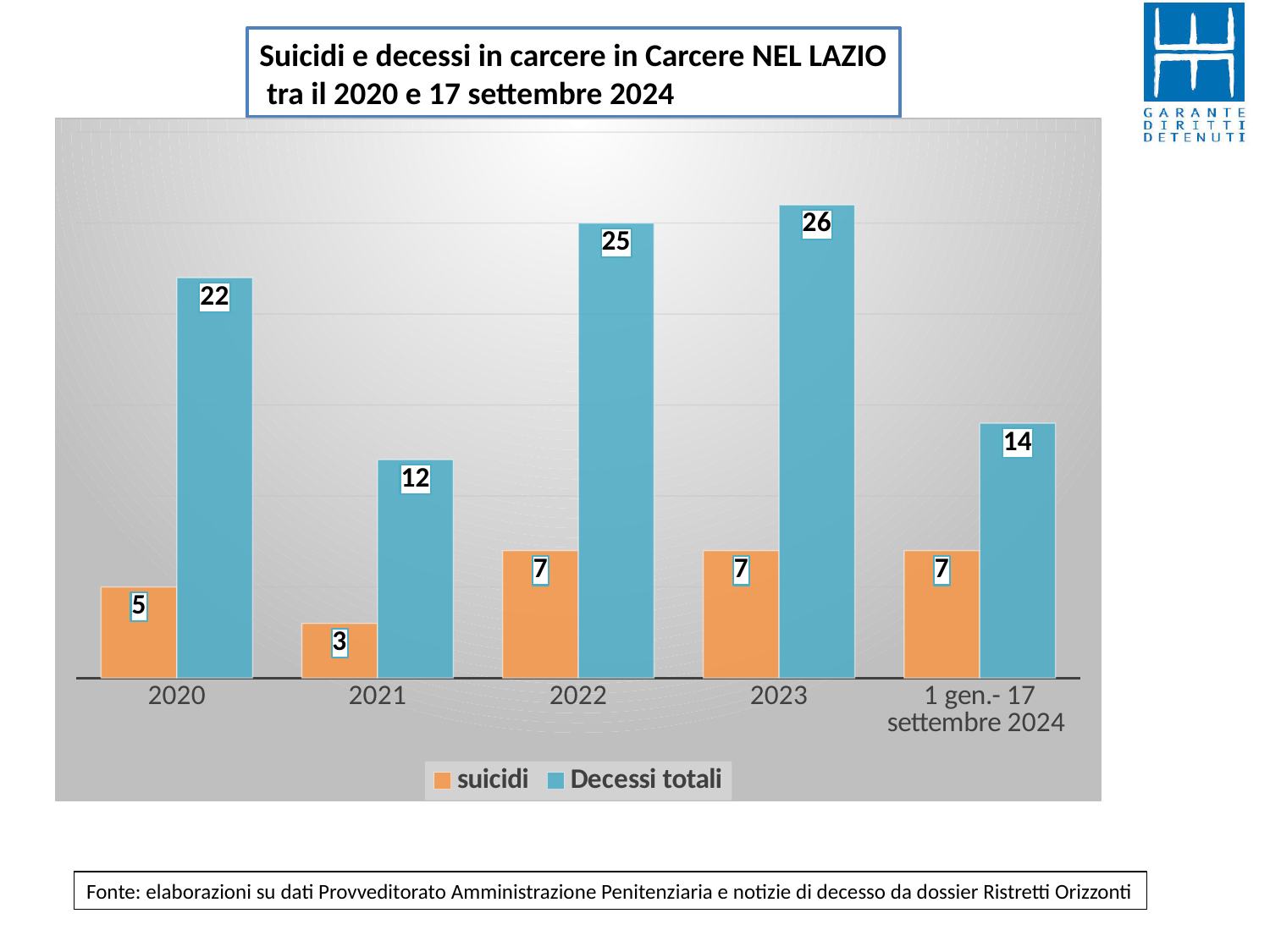
What is the value of 'suicidi' for 2021? 3 Which category has the lowest value for 'suicidi'? 2021 What is the value of 'Decessi totali' for 2020? 22 What kind of chart is shown on the slide? bar chart Which is larger: 'Decessi totali' in 2021 or 'Decessi totali' in 2020? 2020 Does the value of 'Decessi totali' rise or fall from 2021 to 2023? rise How many categories are shown on the x axis? 5 Which year has the highest value for 'Decessi totali'? 2023 What is the value of 'Decessi totali' for the period '1 gen.- 17 settembre 2024'? 14 What is the difference between 'Decessi totali' and 'suicidi' in 2022? 18 How many series does the legend list? 2 What colour are the 'suicidi' bars? orange